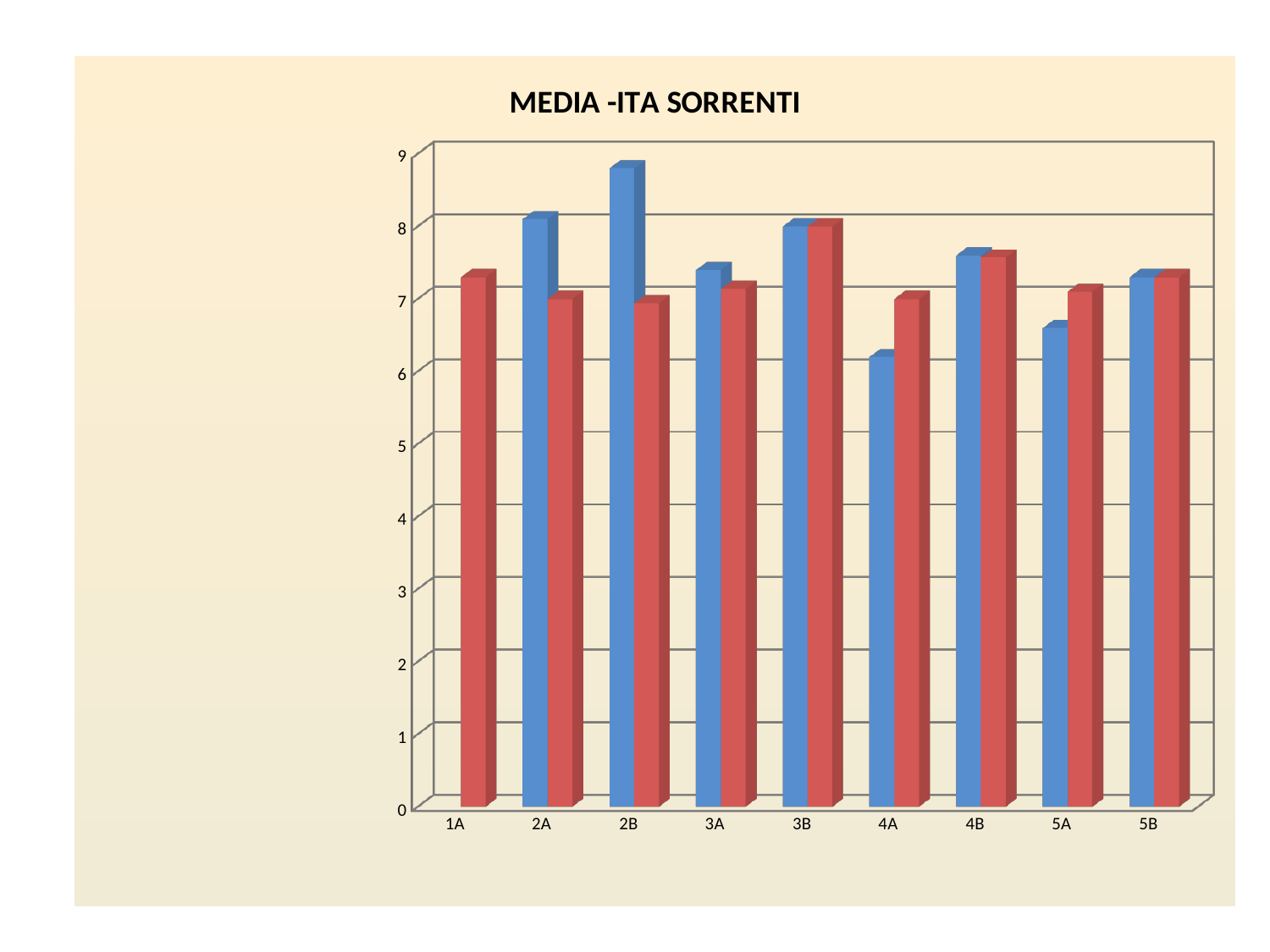
Which category has the shortest blue bar? 4A What kind of chart is shown on the slide? bar chart For category 4A, which bar is taller, the blue one or the red one? red Is the blue bar for 2B greater or less than 8? greater For category 2B, which bar is taller, the blue one or the red one? blue Which category has only a red bar and no blue bar? 1A Is the blue bar for 5A greater or less than 7? less How many categories are shown on the x axis of the chart? 9 Is the blue bar for 4A greater or less than 7? less What is the title of the chart? MEDIA -ITA SORRENTI Which category has the tallest blue bar? 2B